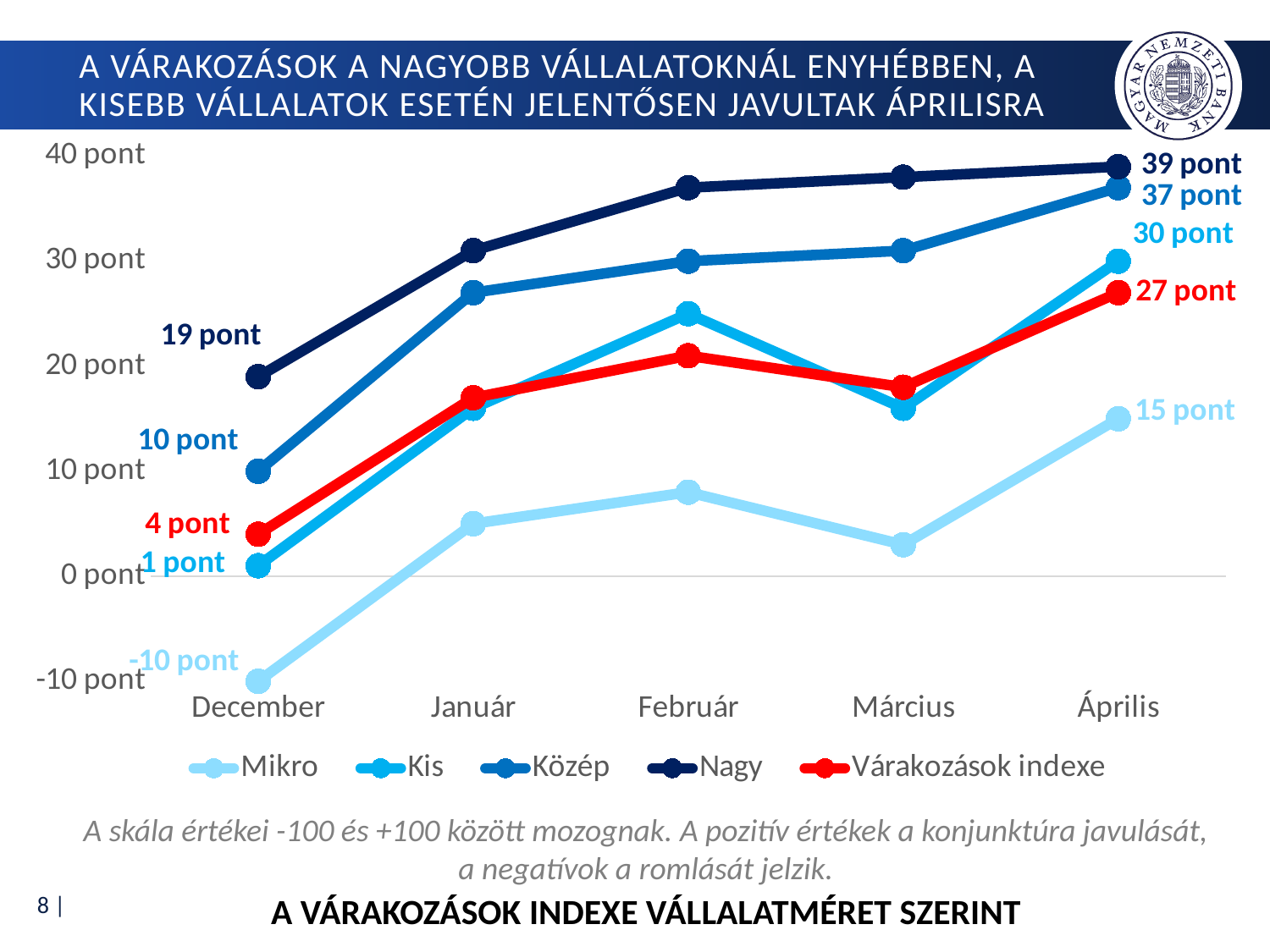
What is the value of the Mikro series in December? -10 pont How many months are shown on the x axis? 5 What is the value of the Várakozások indexe series in Április? 27 pont Which series has the lowest value in December? Mikro How many series does the legend list? 5 What is the value of the Közép series in December? 10 pont Does the Nagy series rise or fall from December to Április? rise Is the value of the Mikro series in Február greater or less than 10 pont? less What kind of chart is shown on the slide? line chart Which series has the highest value in Április? Nagy By how much did the Kis series change from December to Április? 29 pont What is the value of the Nagy series in Április? 39 pont